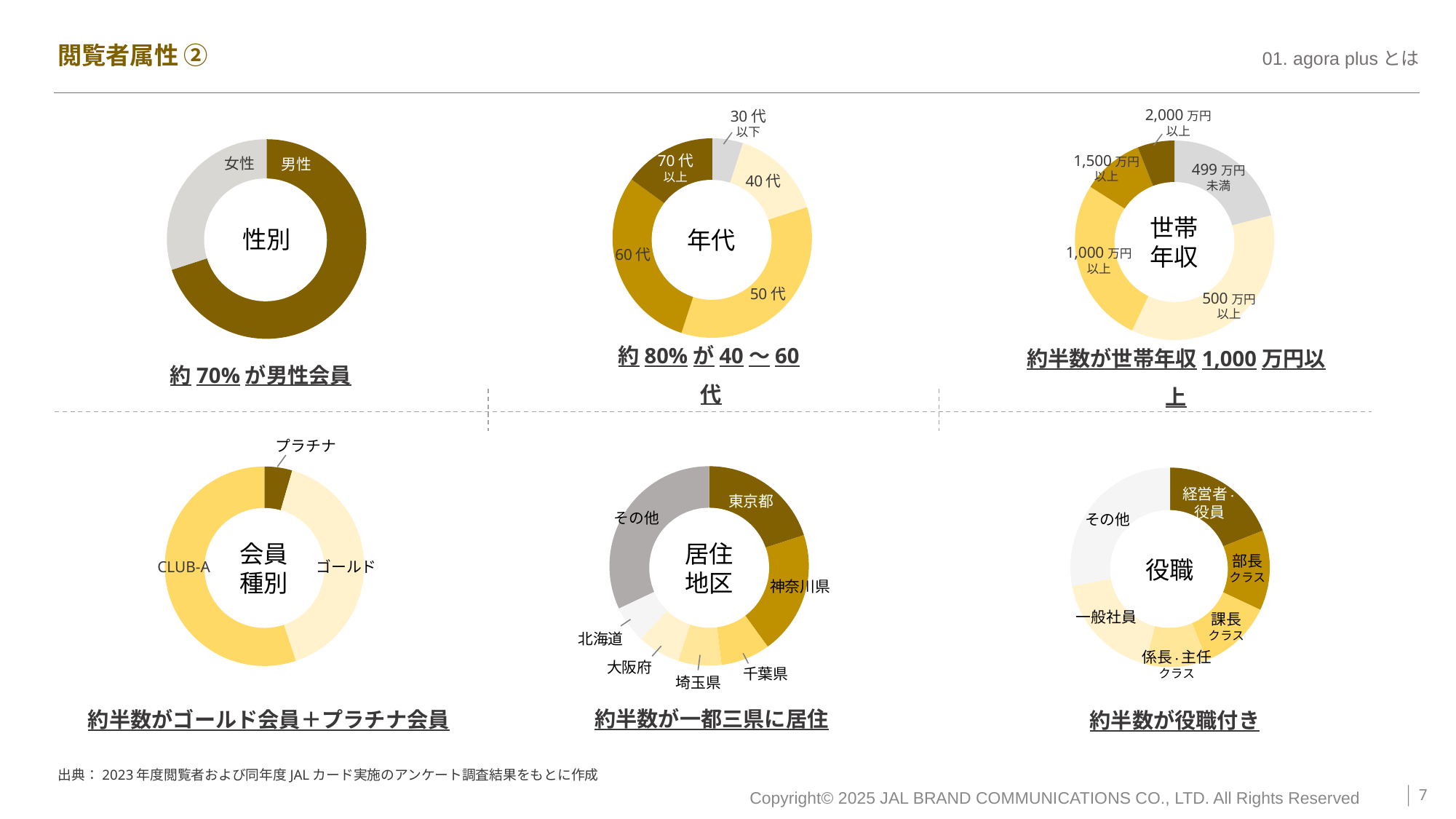
In the 年代 chart, which category has the largest share? 50代 In the 性別 chart, which category is larger, 男性 or 女性? 男性 In the 年代 chart, which category has the smallest share? 30代以下 How many categories does the 年代 chart show? 5 In the 居住地区 chart, which is larger, 東京都 or 千葉県? 東京都 How many categories does the 会員種別 chart show? 3 How many charts are shown on the slide? 6 In the 世帯年収 chart, which category has the smallest share? 2,000万円以上 In the 会員種別 chart, which category has the largest share? CLUB-A In the 会員種別 chart, which category has the smallest share? プラチナ What kind of chart is the 性別 chart? Pie (donut) chart